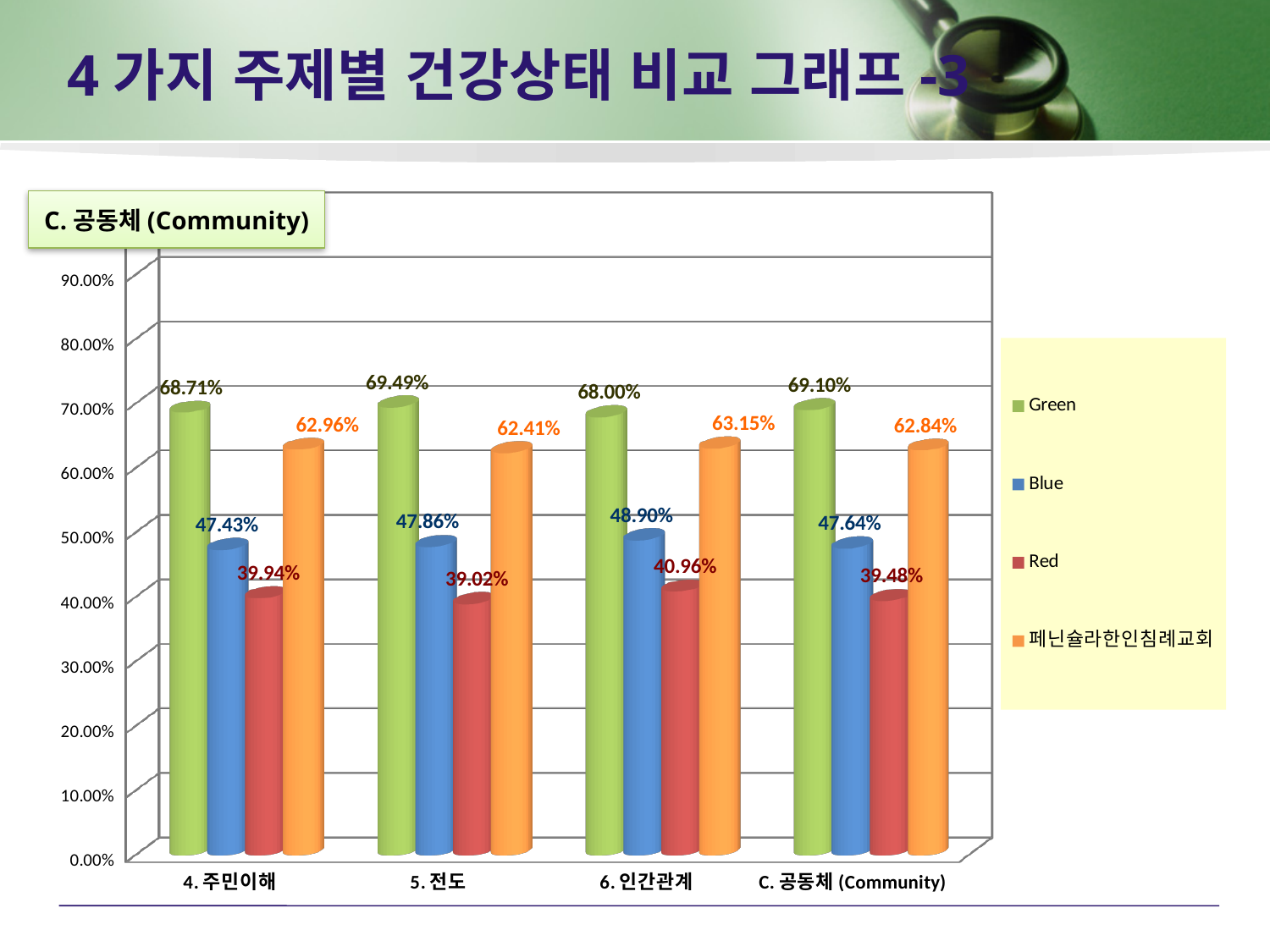
What is the Blue value for 6. 인간관계? 48.90% What is the difference between the Green and Blue values for 4. 주민이해? 21.28% What kind of chart is shown on the slide? Bar chart What is the Red value for C. 공동체 (Community)? 39.48% Which is larger for 6. 인간관계: the Blue value or the Red value? Blue What is the Green value for 5. 전도? 69.49% Which category has the highest Green value? 5. 전도 How many series does the legend list? 4 What is the label in the box at the top left of the chart? C. 공동체 (Community) How many categories are shown on the x axis? 4 Which category has the lowest Red value? 5. 전도 What is the 페닌슐라한인침례교회 value for 4. 주민이해? 62.96%